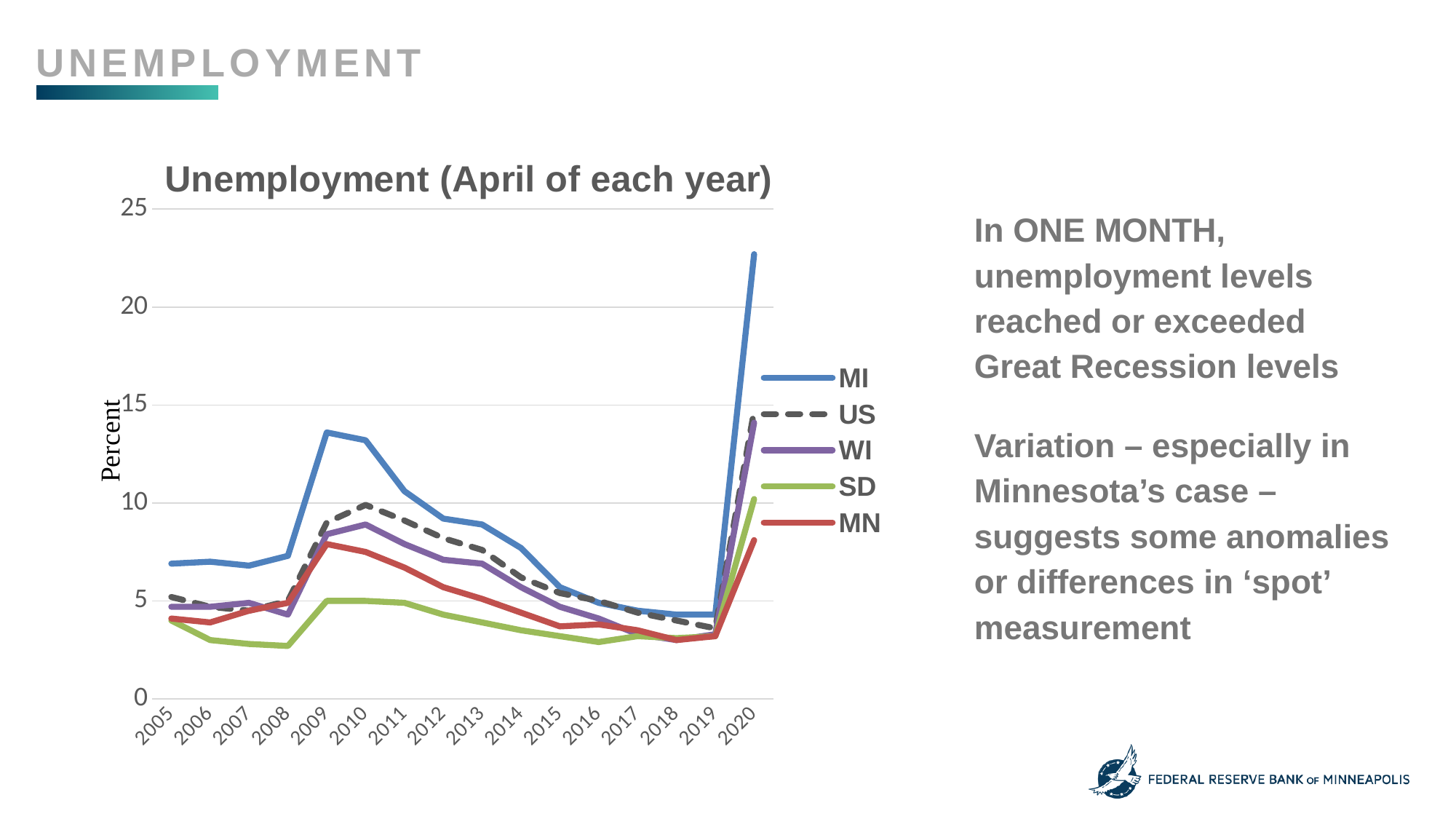
How many years are shown on the x axis? 16 Which is larger in 2020, the value for WI or the value for MN? WI How many series does the legend list? 5 Is the value for MI in 2009 greater or less than 10? greater Which series has the highest value in 2020? MI What kind of chart is shown on the slide? line chart Which is larger in 2010, the value for US or the value for SD? US Is the value for MI in 2020 greater or less than 20? greater What is the title of the chart? Unemployment (April of each year) Is the value for SD in 2009 greater or less than 10? less Does the MI series rise or fall between 2019 and 2020? rise Which series has the lowest value in 2010? SD